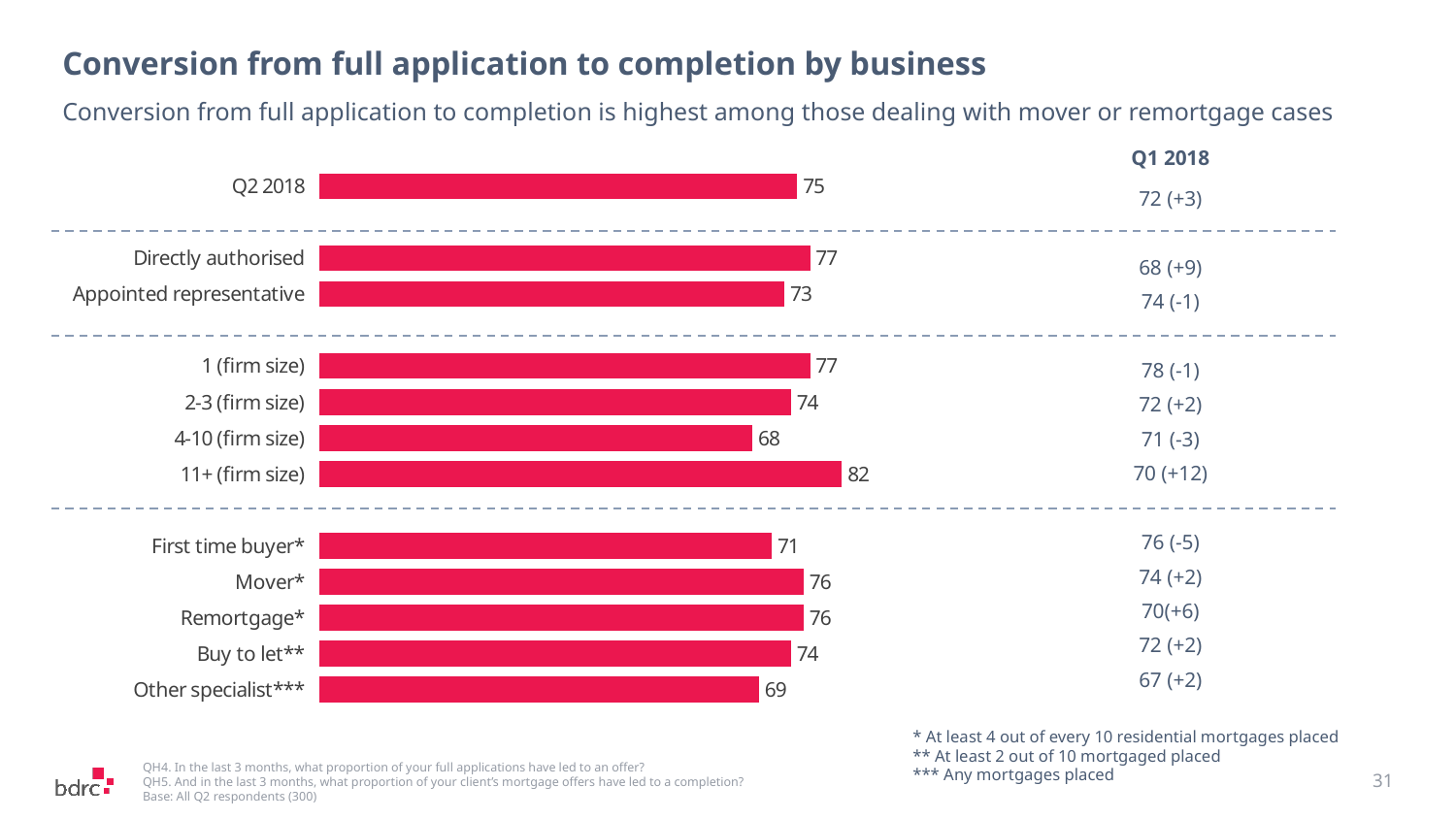
What is the value for Other specialist***? 69 What is the Q1 2018 value shown for 11+ (firm size)? 70 (+12) Which category has the lowest value? 4-10 (firm size) What is the value for 11+ (firm size)? 82 Which is larger, the value for Buy to let** or the value for Other specialist***? Buy to let** How many bars are plotted on the chart? 12 Which category has the highest value? 11+ (firm size) What kind of chart is shown on the slide? Bar chart What is the value for Appointed representative? 73 What is the difference between the values for Directly authorised and Appointed representative? 4 Which is larger, the value for Mover* or the value for First time buyer*? Mover* What is the difference between the values for 11+ (firm size) and 4-10 (firm size)? 14